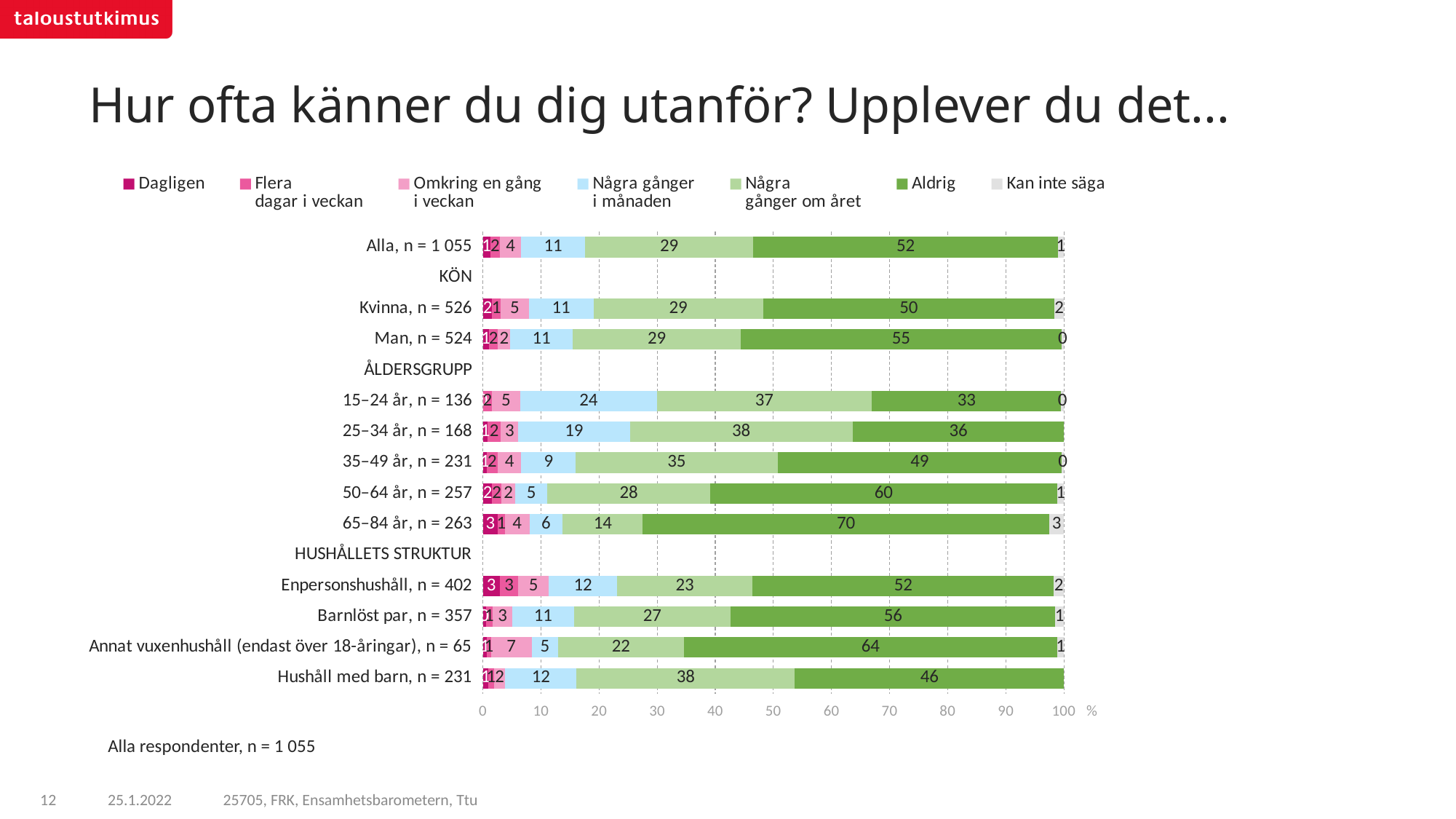
Which group has the highest 'Aldrig' value? 65–84 år, n = 263 What is the 'Några gånger i månaden' value for 15–24 år, n = 136? 24 What is the 'Aldrig' value for Annat vuxenhushåll (endast över 18-åringar), n = 65? 64 What is the 'Kan inte säga' value for Alla, n = 1 055? 1 Which has a larger 'Aldrig' value: Barnlöst par, n = 357 or Hushåll med barn, n = 231? Barnlöst par, n = 357 What is the 'Dagligen' value for Enpersonshushåll, n = 402? 3 Which group has the lowest 'Aldrig' value? 15–24 år, n = 136 What is the difference between the 'Aldrig' values for Man, n = 524 and Kvinna, n = 526? 5 What is the 'Aldrig' value for the group 65–84 år, n = 263? 70 How many series does the legend list? 7 What is the 'Några gånger om året' value for 25–34 år, n = 168? 38 What type of chart is shown on the slide? stacked bar chart